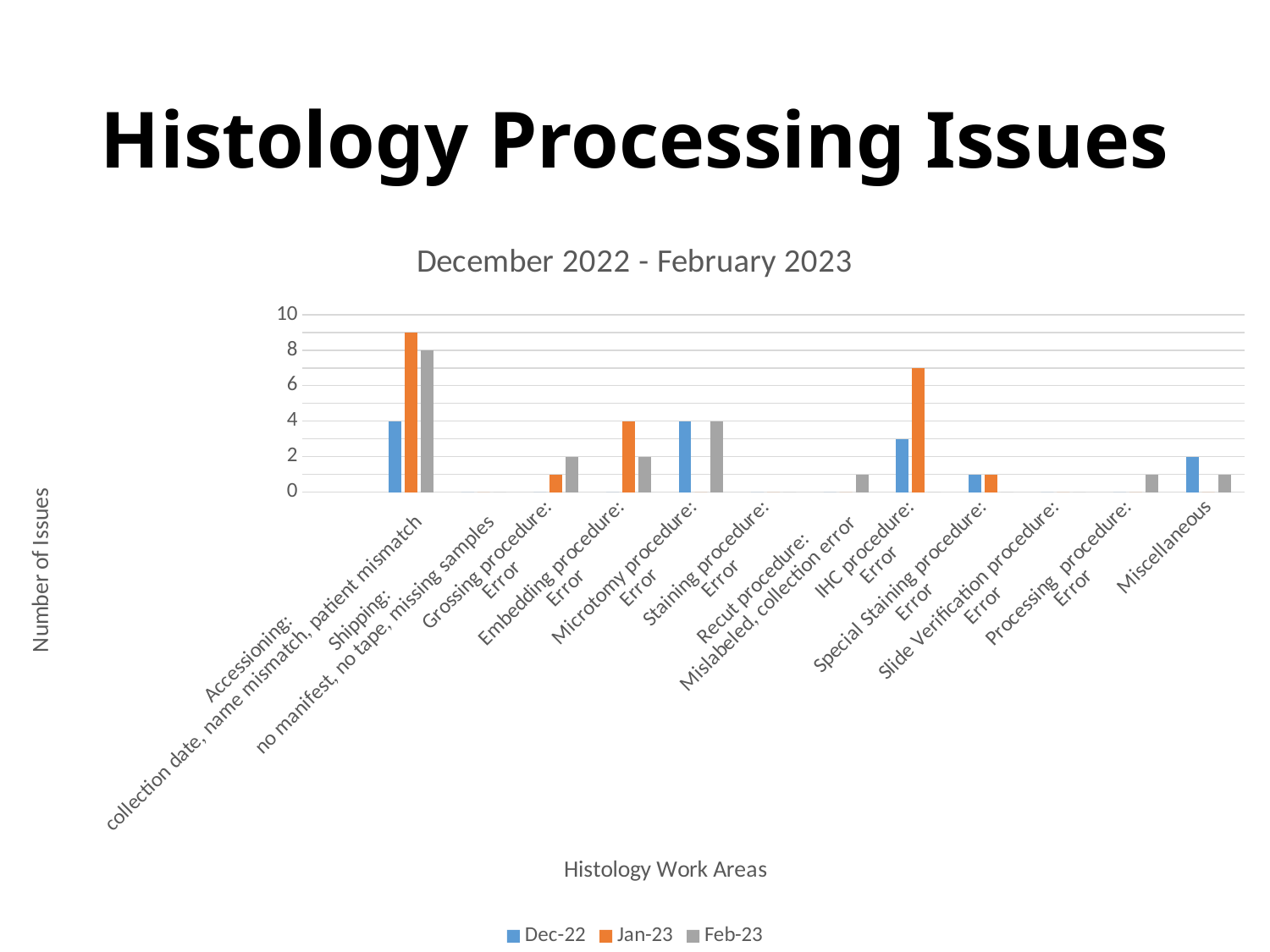
Which series has the highest value for Accessioning? Jan-23 Is the Jan-23 value for Accessioning greater or less than 8? greater What is the Dec-22 value for Miscellaneous? 2 Is the Jan-23 value for IHC procedure: Error greater or less than 6? greater How many series does the legend list? 3 How many histology work area categories are shown on the x axis? 12 What is the Dec-22 value for Accessioning? 4 What kind of chart is shown on the slide? bar chart What is the Jan-23 value for Embedding procedure: Error? 4 Which is larger for Embedding procedure: Error, the Jan-23 value or the Feb-23 value? Jan-23 What is the title of the chart? December 2022 - February 2023 What is the Feb-23 value for Accessioning? 8